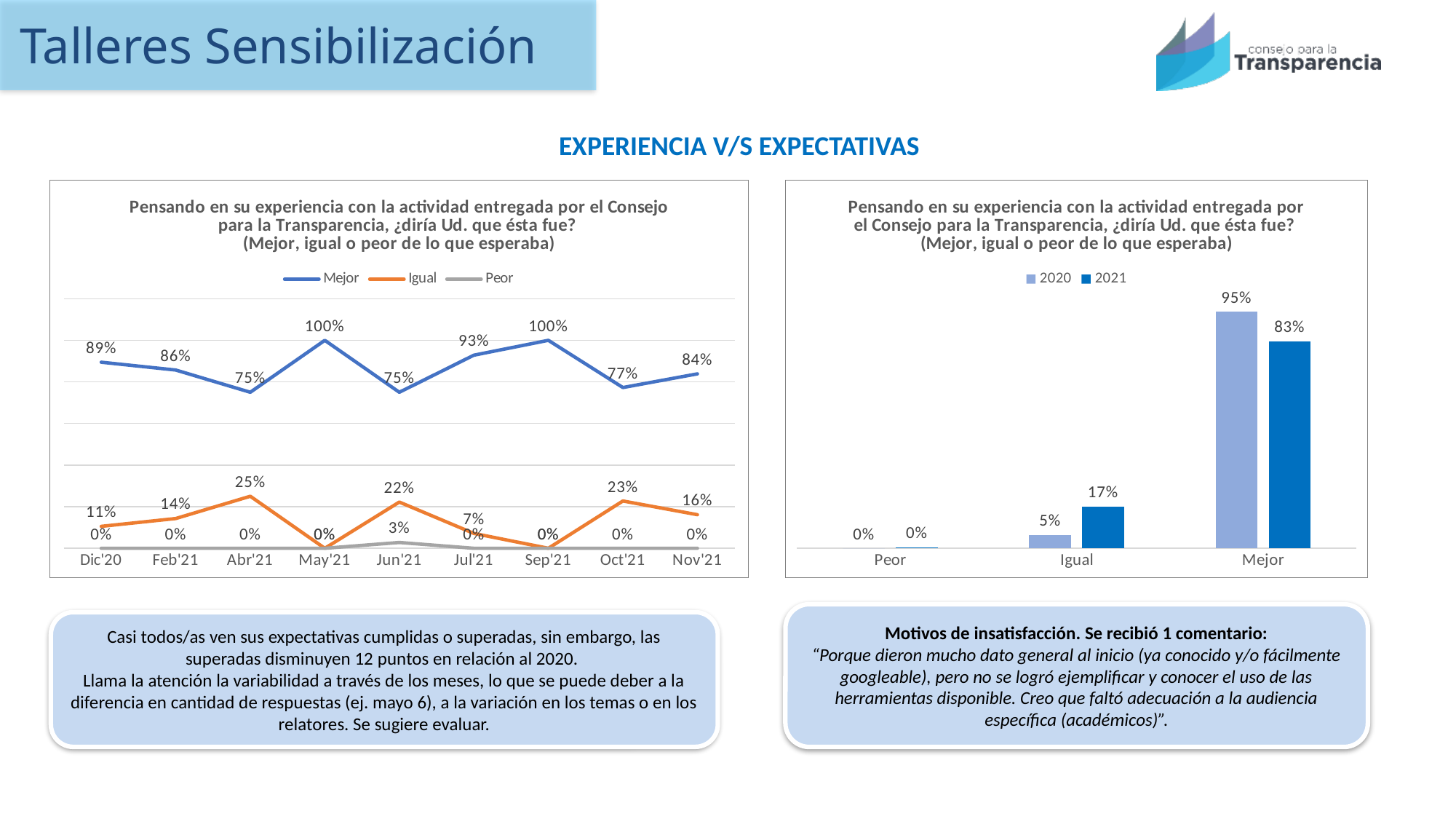
In the left chart, in which months does the Mejor series reach its highest value? May'21 and Sep'21 In the left chart, what is the value of the Mejor series for Jul'21? 93% What kind of chart is the left chart? Line chart In the left chart, what is the difference between the Mejor values for Dic'20 and Nov'21? 5% What kind of chart is the right chart? Bar chart In the left chart, what is the value of the Peor series for Jun'21? 3% In the left chart, what is the value of the Igual series for Abr'21? 25% In the left chart, how many series does the legend list? 3 In the left chart, how many months are shown on the x axis? 9 In the right chart, what is the 2021 value for Igual? 17% In the right chart, what is the difference between the 2020 and 2021 values for Mejor? 12% In the right chart, which is larger for Mejor, the 2020 value or the 2021 value? 2020